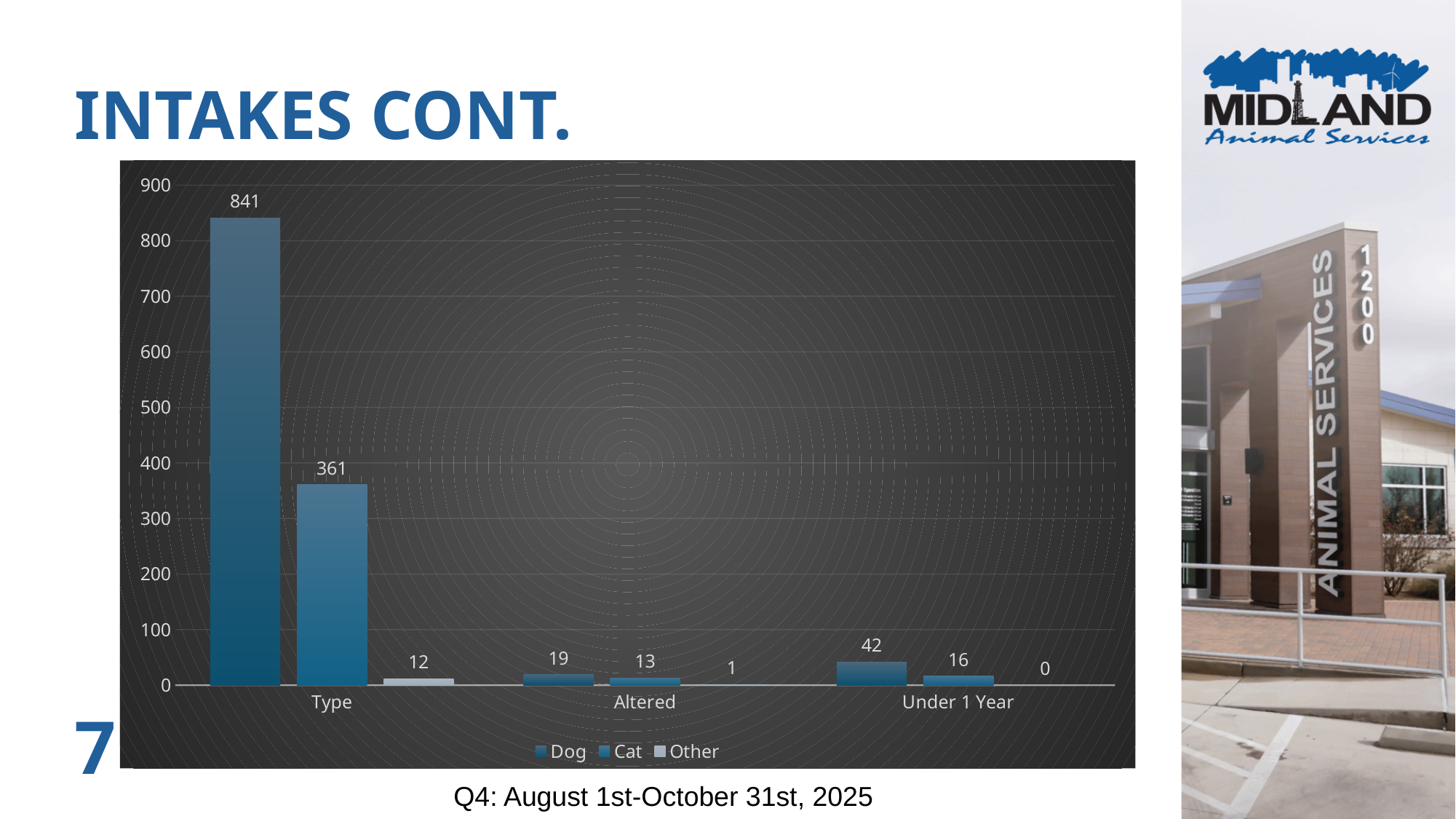
How many categories are shown on the x axis? 3 What is the value for Dog in the Under 1 Year category? 42 Which series has the lowest value in the Altered category? Other Which series has the highest value in the Type category? Dog What kind of chart is shown on the slide? Bar chart What is the difference between the Dog and Cat values in the Type category? 480 Which is larger: the Dog value for Altered or the Dog value for Under 1 Year? Under 1 Year What is the value for Cat in the Type category? 361 What is the value for Other in the Altered category? 1 How many series does the legend list? 3 What is the value for Dog in the Type category? 841 What is the value for Other in the Under 1 Year category? 0